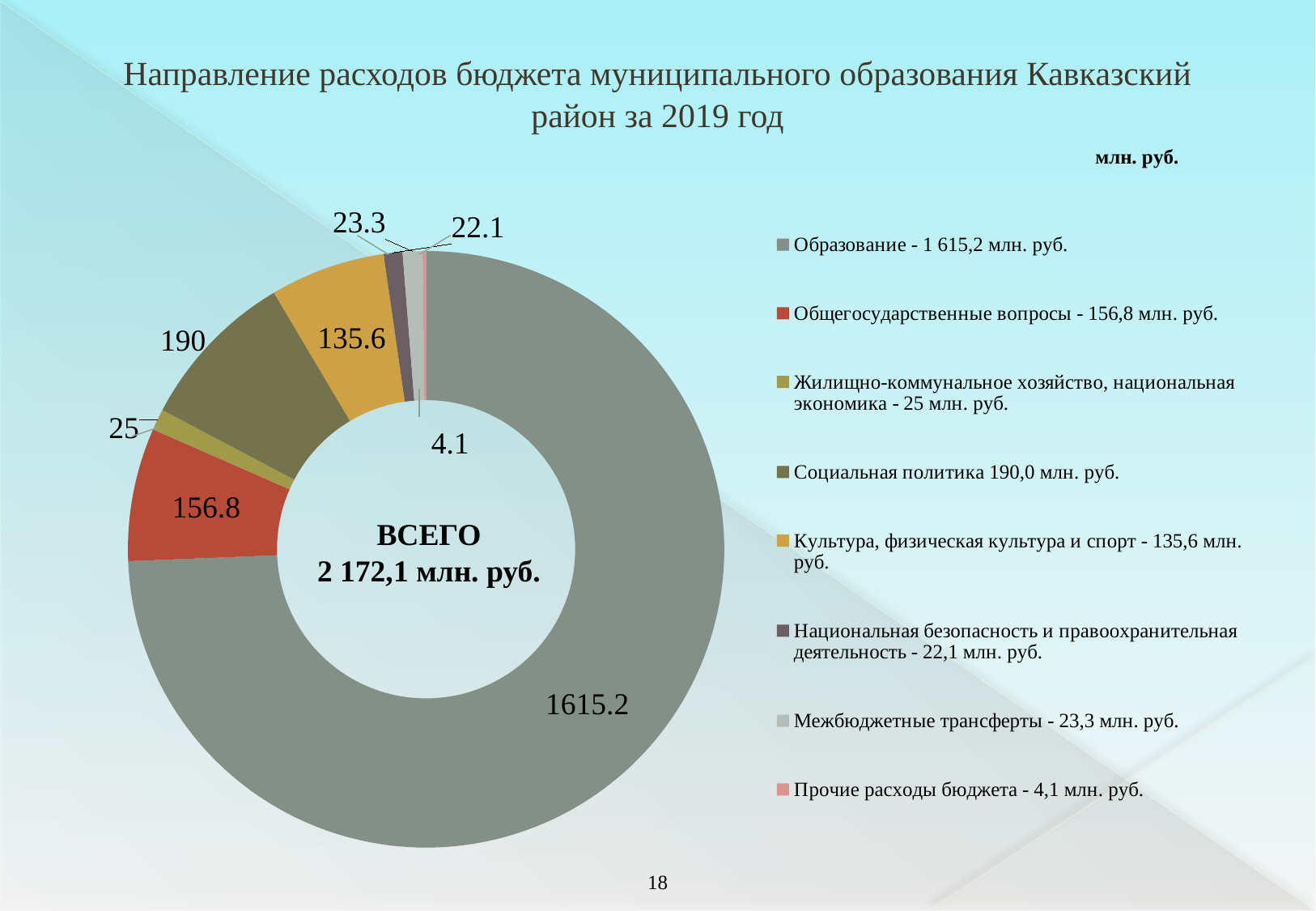
What is the difference between the values for Межбюджетные трансферты and Национальная безопасность и правоохранительная деятельность? 1.2 What is the value for Образование on the chart? 1615.2 What kind of chart is shown on the slide? doughnut chart What total amount is printed in the centre of the chart? 2 172,1 млн. руб. How many categories are shown on the chart? 8 What is the value for Социальная политика on the chart? 190 Which category has the smallest value on the chart? Прочие расходы бюджета What is the difference between the values for Социальная политика and Общегосударственные вопросы? 33.2 What is the value for Общегосударственные вопросы on the chart? 156.8 Which is larger: the value for Культура, физическая культура и спорт or the value for Общегосударственные вопросы? Общегосударственные вопросы Which category has the largest value on the chart? Образование What is the value for Прочие расходы бюджета on the chart? 4.1